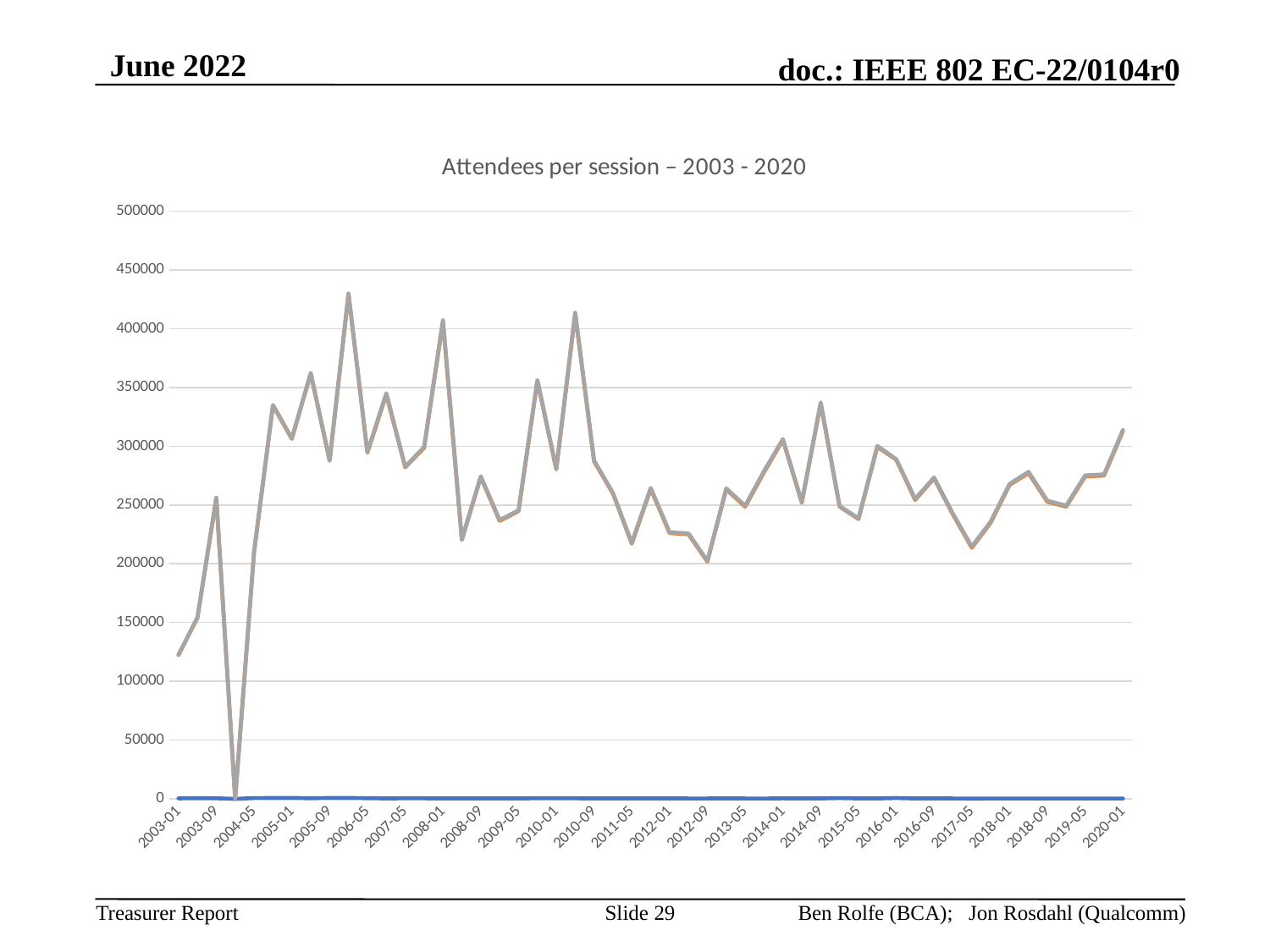
Which is larger, the value for 2008-01 or the value for 2012-09? 2008-01 What is the title of the chart? Attendees per session – 2003 - 2020 What is the highest value shown on the vertical axis of the chart? 500000 What kind of chart is shown on the slide? line chart Is the value for 2017-05 greater or less than 250000? less Is the value for 2004-05 greater or less than 50000? greater Is the value for 2012-09 greater or less than 250000? less Does the line rise or fall between 2003-01 and 2003-09? rise Which is larger, the value for 2005-01 or the value for 2003-01? 2005-01